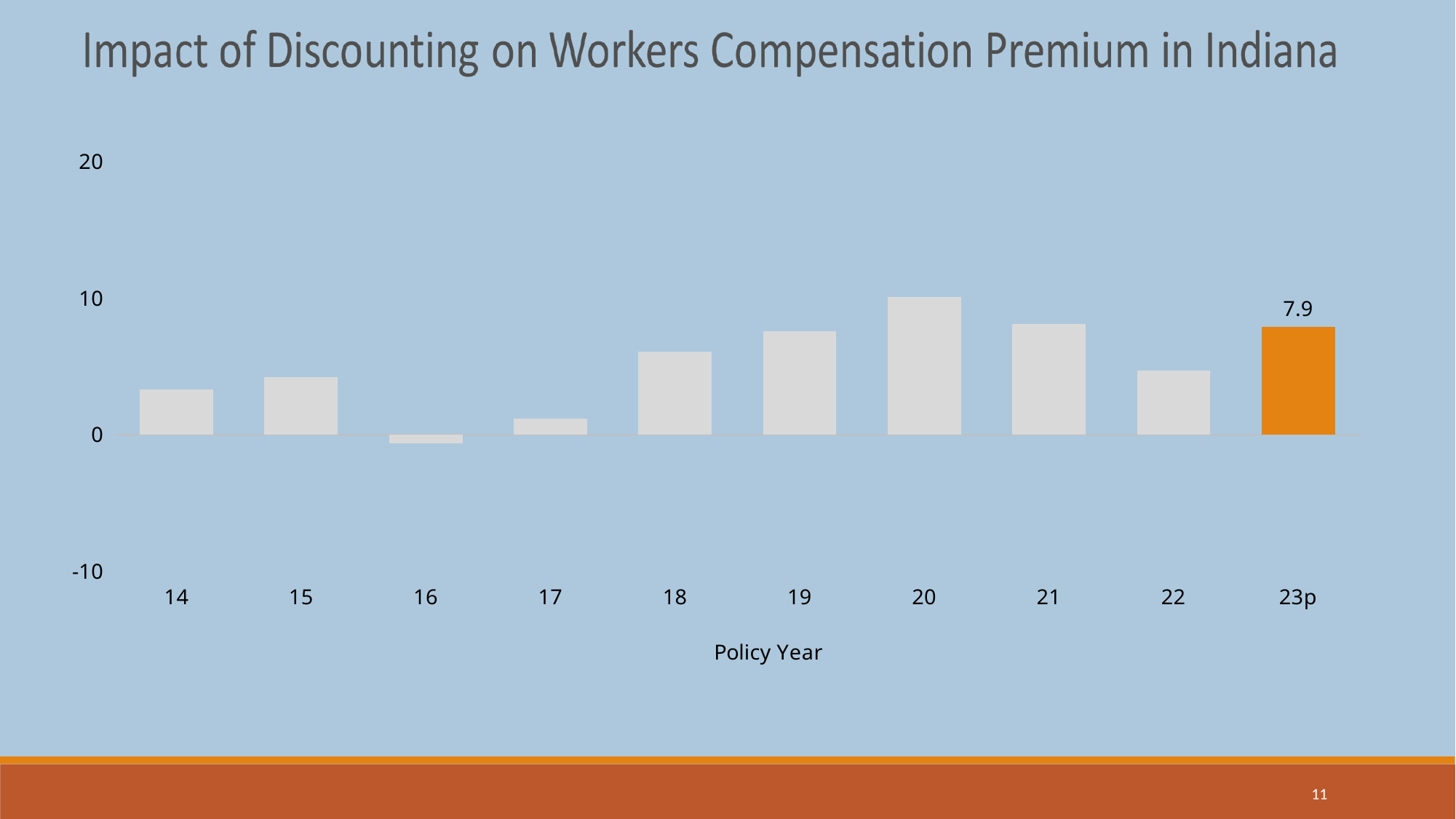
What is the title of the x axis? Policy Year Do the values rise or fall from policy year 17 to policy year 20? rise Which is larger, the value for policy year 20 or policy year 14? 20 Is the value for policy year 14 greater or less than 0? greater How many policy years are shown on the x axis? 10 What is the value for policy year 23p? 7.9 Which is larger, the value for policy year 15 or policy year 17? 15 Which policy year has the highest bar? 20 Which policy year has the lowest bar? 16 Is the value for policy year 18 greater or less than 10? less What kind of chart is shown on the slide? bar chart Is the value for policy year 16 greater or less than 0? less